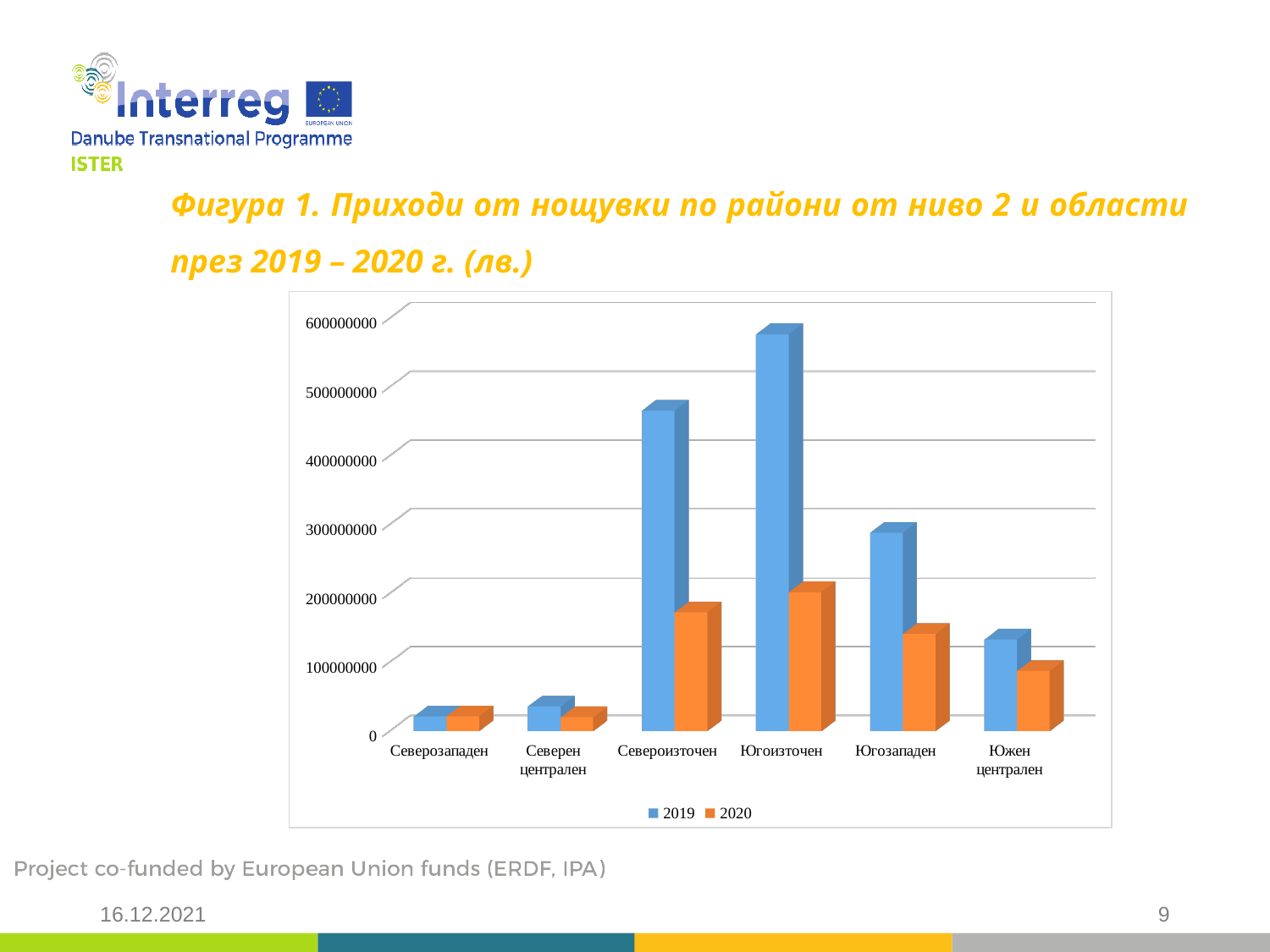
What are the two series listed in the chart's legend? 2019 and 2020 Which region has the lowest value for 2019? Северозападен Is the 2019 value for Североизточен greater or less than 400000000? greater Is the 2019 value for Северозападен greater or less than 100000000? less How many regions (categories) are shown on the x axis of the chart? 6 How many series does the chart's legend list? 2 What kind of chart is shown on the slide? bar chart Is the 2020 value for Североизточен greater or less than 200000000? less Which region has the highest value for 2019? Югоизточен Which region has the highest value for 2020? Югоизточен Which is larger: the 2019 value for Североизточен or the 2019 value for Югозападен? Североизточен